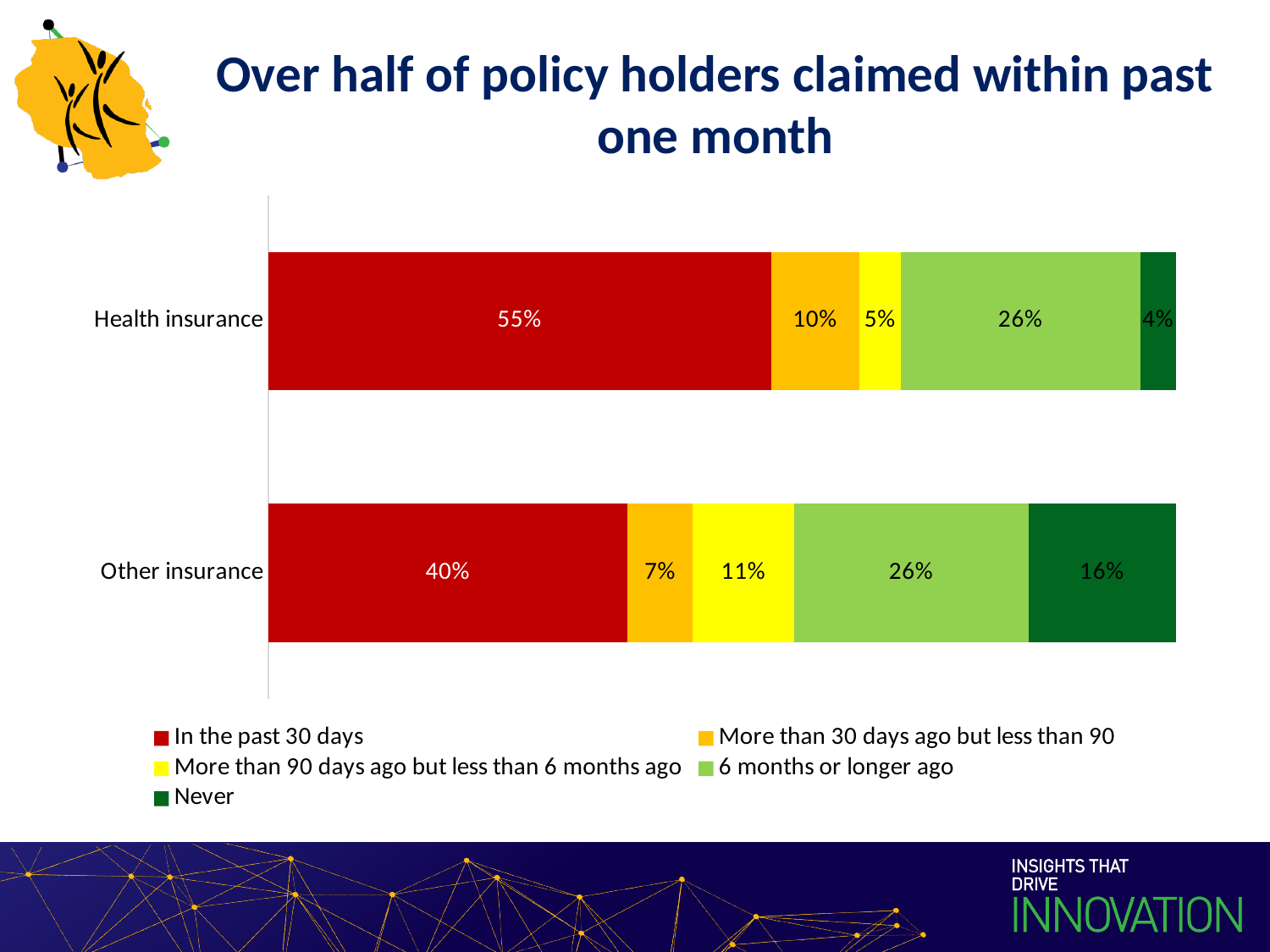
What percentage of Other insurance policy holders claimed in the past 30 days? 40% What percentage of Health insurance policy holders claimed in the past 30 days? 55% What is the difference between the 'In the past 30 days' values for Health insurance and Other insurance? 15% Which series is shown in dark green in the legend? Never What is the value for '6 months or longer ago' for Other insurance? 26% Which category has the larger 'Never' value, Health insurance or Other insurance? Other insurance How many categories are shown on the chart? 2 What is the total of the stacked bar for Health insurance? 100% What is the value for 'More than 90 days ago but less than 6 months ago' for Health insurance? 5% What kind of chart is shown on the slide? Stacked bar chart How many series does the legend list? 5 What is the value for 'Never' for Other insurance? 16%